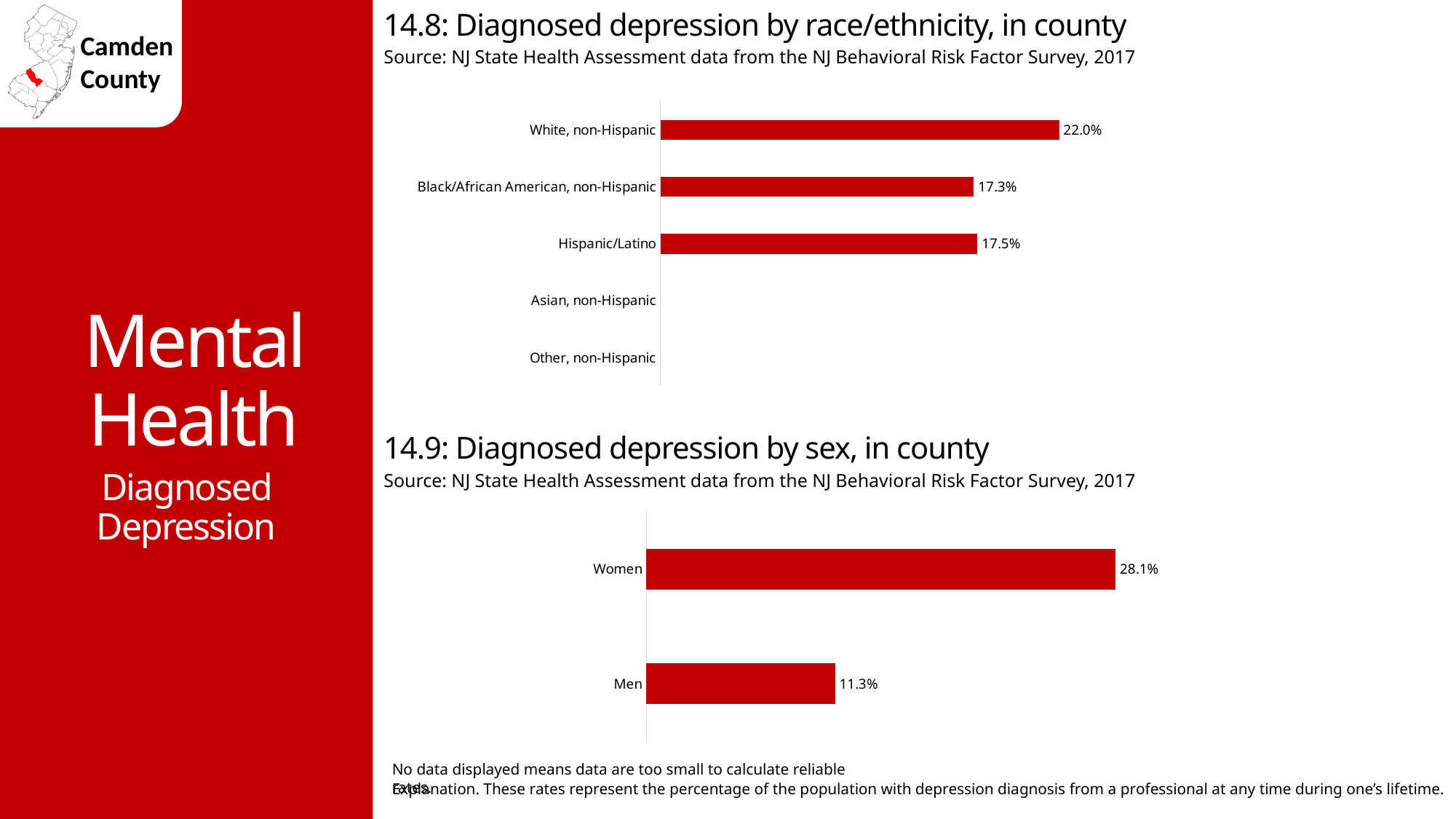
In the chart '14.8: Diagnosed depression by race/ethnicity, in county', which category has the highest value? White, non-Hispanic In the chart '14.8: Diagnosed depression by race/ethnicity, in county', what is the value for Hispanic/Latino? 17.5% In the chart '14.9: Diagnosed depression by sex, in county', which category has the lower value? Men In the chart '14.8: Diagnosed depression by race/ethnicity, in county', what is the difference between the values for White, non-Hispanic and Hispanic/Latino? 4.5% In the chart '14.8: Diagnosed depression by race/ethnicity, in county', what is the value for Black/African American, non-Hispanic? 17.3% In the chart '14.9: Diagnosed depression by sex, in county', what is the value for Men? 11.3% In the chart '14.9: Diagnosed depression by sex, in county', what is the value for Women? 28.1% In the chart '14.8: Diagnosed depression by race/ethnicity, in county', which categories have no bar displayed? Asian, non-Hispanic and Other, non-Hispanic In the chart '14.8: Diagnosed depression by race/ethnicity, in county', what is the value for White, non-Hispanic? 22.0% In the chart '14.8: Diagnosed depression by race/ethnicity, in county', how many categories are listed on the axis? 5 What type of chart is '14.9: Diagnosed depression by sex, in county'? Bar chart In the chart '14.9: Diagnosed depression by sex, in county', what is the difference between the values for Women and Men? 16.8%